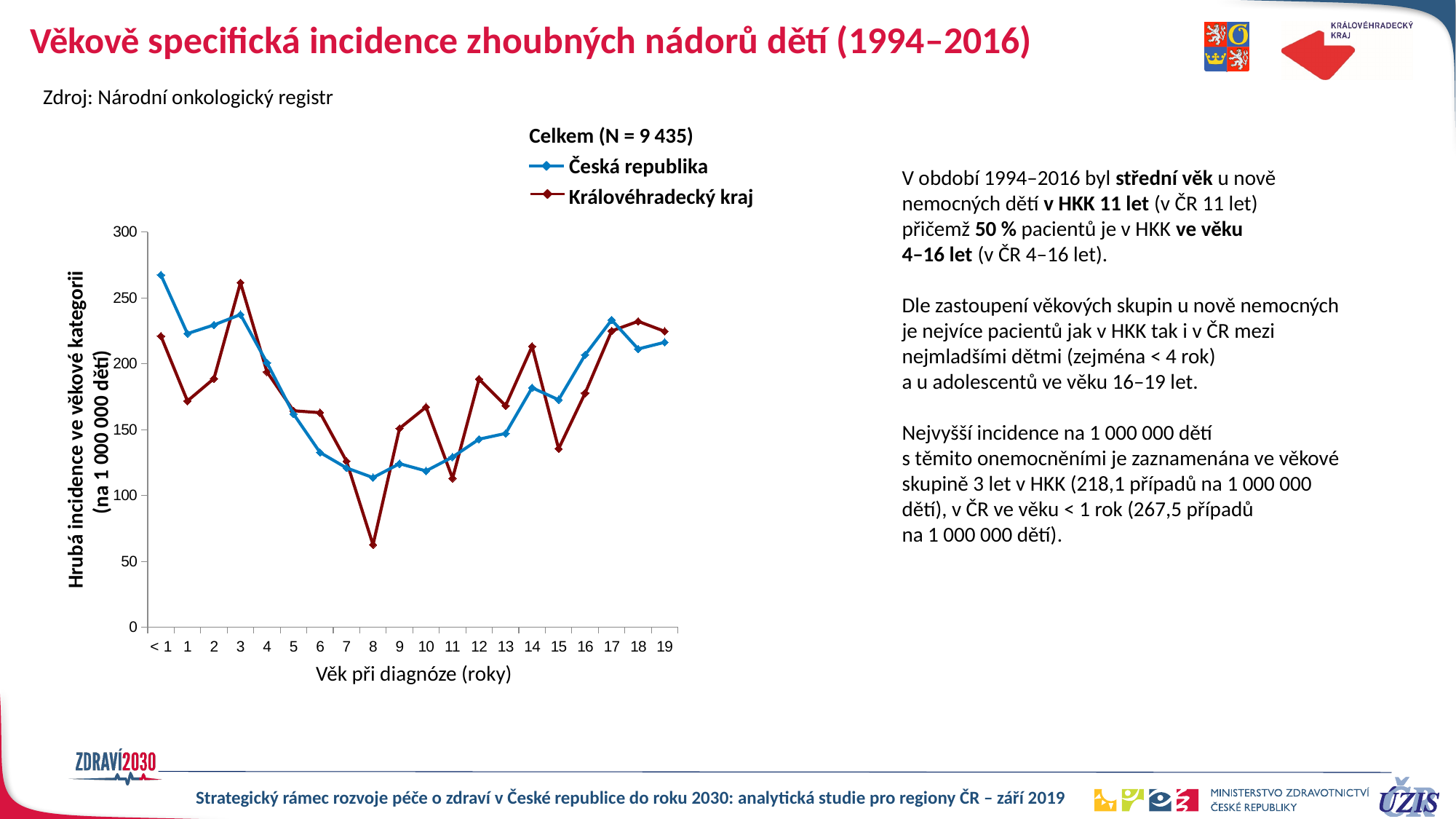
How many age categories are shown on the x axis of the chart? 20 Is the value for Královéhradecký kraj at age 8 greater or less than 100? less At which age category does the Česká republika series reach its highest value? < 1 Is the value for Česká republika at age 17 greater or less than 200? greater What is the title shown above the chart legend? Celkem (N = 9 435) Is the value for Česká republika at age < 1 greater or less than 250? greater What kind of chart is shown on the slide? line chart How many series does the chart legend list? 2 At which age category does the Královéhradecký kraj series reach its highest value? 3 At age 8, which series has the higher value, Česká republika or Královéhradecký kraj? Česká republika At which age category does the Královéhradecký kraj series reach its lowest value? 8 At age 3, which series has the higher value, Česká republika or Královéhradecký kraj? Královéhradecký kraj